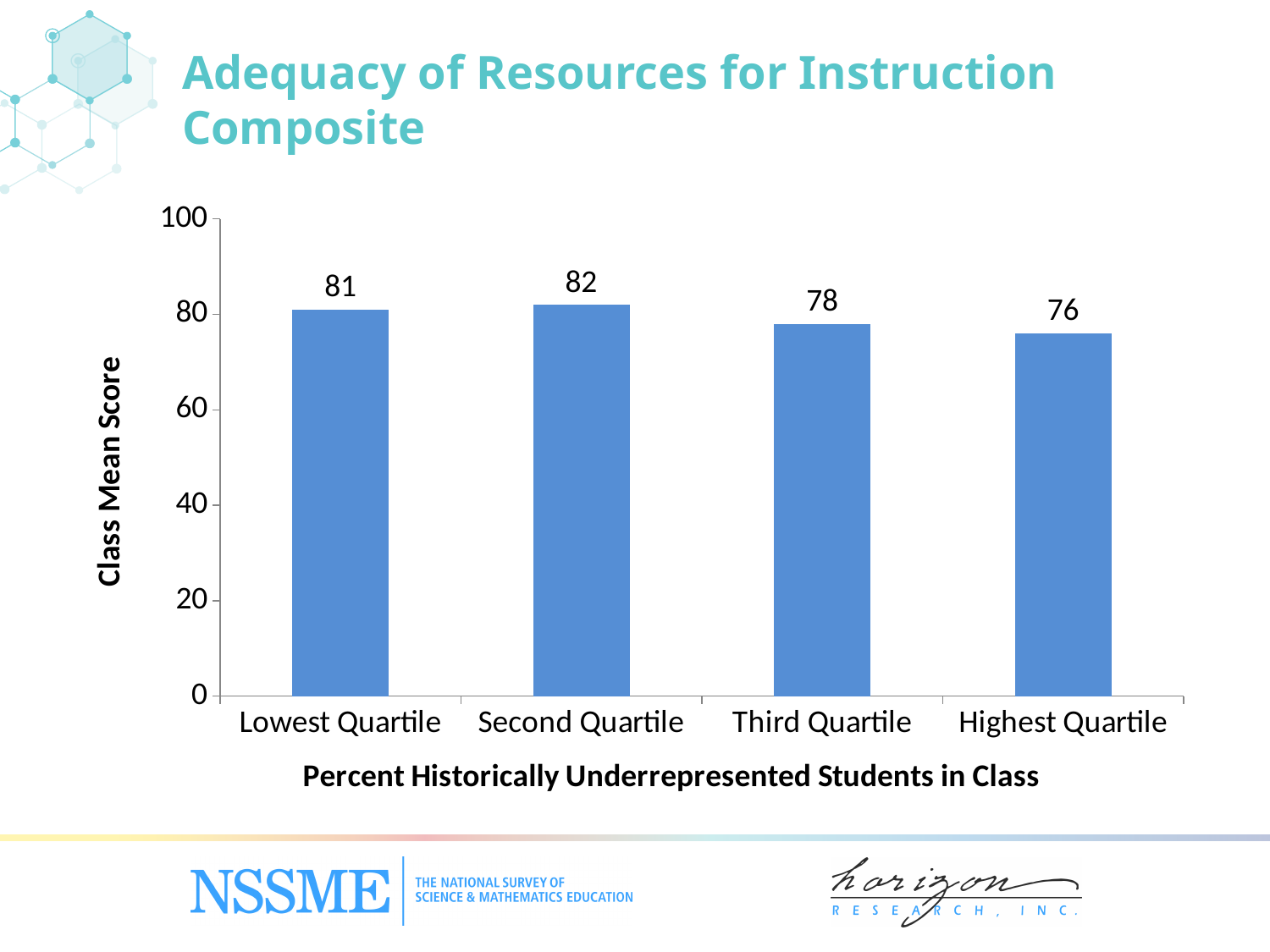
Do the class mean scores rise or fall from the Second Quartile to the Highest Quartile? Fall How many quartile categories are shown on the x axis? 4 What is the class mean score for the Second Quartile? 82 Which has a larger class mean score, the Lowest Quartile or the Third Quartile? Lowest Quartile Which quartile has the lowest class mean score? Highest Quartile What is the class mean score for the Third Quartile? 78 What kind of chart is shown on the slide? Bar chart What is the label of the y axis? Class Mean Score What is the class mean score for the Highest Quartile? 76 Which quartile has the highest class mean score? Second Quartile What is the difference between the class mean scores for the Second Quartile and the Highest Quartile? 6 What is the class mean score for the Lowest Quartile? 81